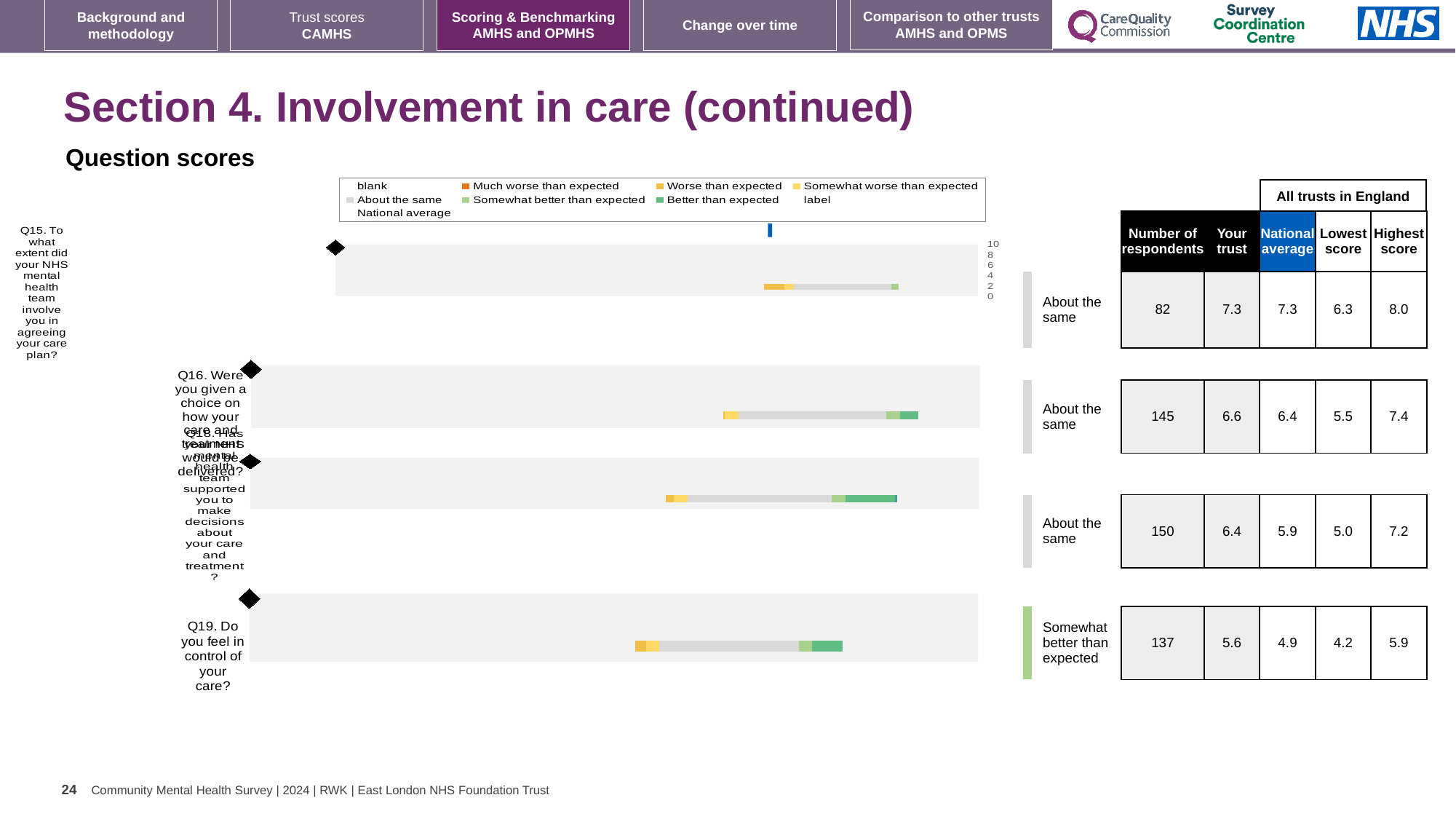
How many entries does the chart legend list? 9 What is the 'Your trust' score for Q19 in the table beside the chart? 5.6 How many respondents are shown for Q15 in the table beside the chart? 82 What is the difference between the 'Your trust' score and the national average for Q16? 0.2 What kind of chart is shown on the slide? bar chart Which question has the lowest 'Your trust' score? Q19 Which question has the highest number of respondents? Q18 Which has the higher 'Your trust' score, Q15 or Q19? Q15 How many survey questions are plotted in the chart? 4 Which question is rated 'Somewhat better than expected'? Q19 What is the national average for Q18 in the table beside the chart? 5.9 What colour represents 'Better than expected' in the chart legend? green